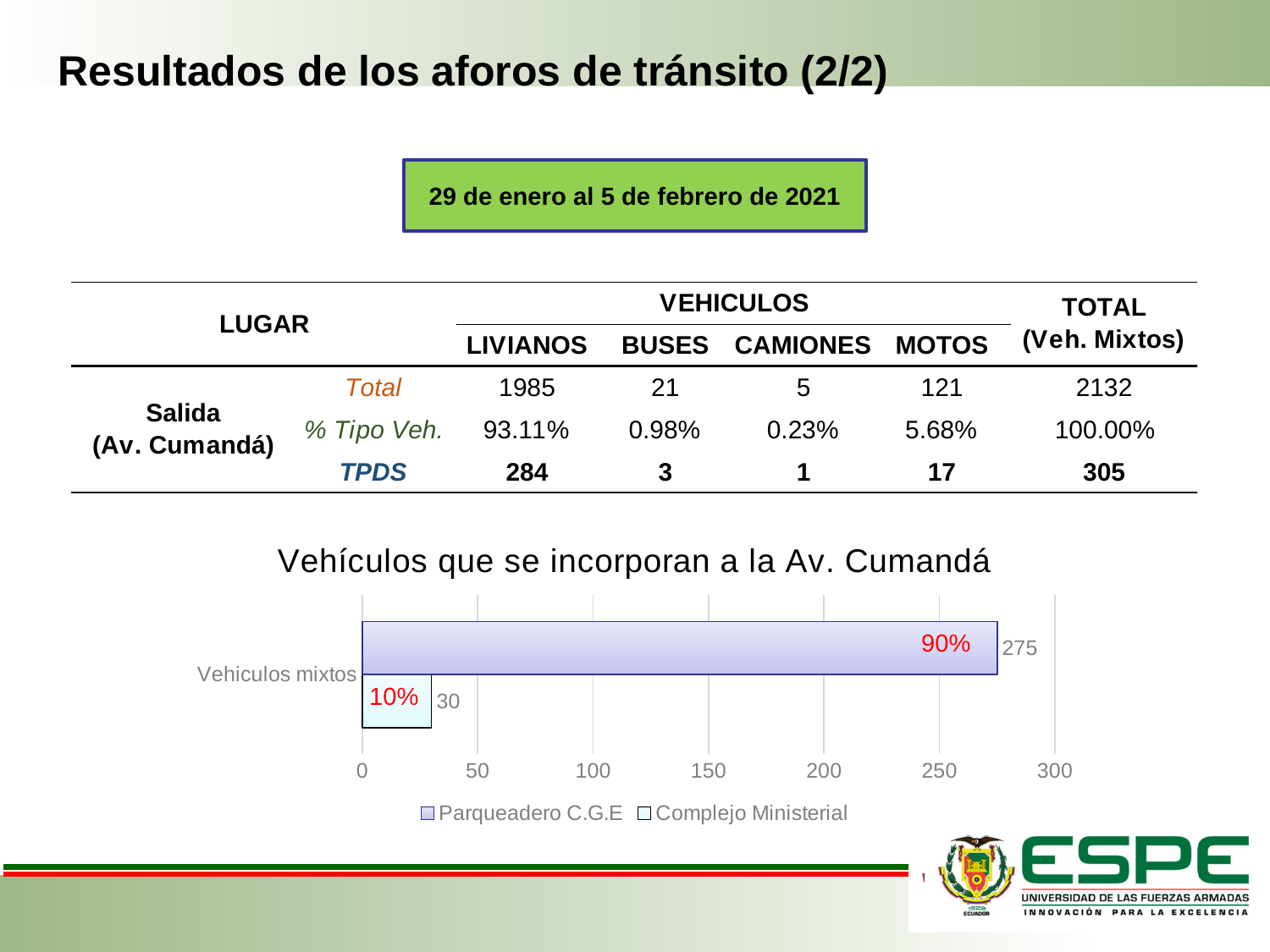
In the chart 'Vehículos que se incorporan a la Av. Cumandá', what is the value for Complejo Ministerial? 30 In the chart 'Vehículos que se incorporan a la Av. Cumandá', what percentage label is shown on the Complejo Ministerial bar? 10% In the chart 'Vehículos que se incorporan a la Av. Cumandá', what is the value for Parqueadero C.G.E? 275 In the chart 'Vehículos que se incorporan a la Av. Cumandá', what is the difference between the Parqueadero C.G.E value and the Complejo Ministerial value? 245 In the chart 'Vehículos que se incorporan a la Av. Cumandá', what percentage label is shown on the Parqueadero C.G.E bar? 90% In the chart 'Vehículos que se incorporan a la Av. Cumandá', which series has the lower value? Complejo Ministerial What is the category label on the vertical axis of the chart 'Vehículos que se incorporan a la Av. Cumandá'? Vehiculos mixtos In the chart 'Vehículos que se incorporan a la Av. Cumandá', which series has the higher value? Parqueadero C.G.E What type of chart is shown under the title 'Vehículos que se incorporan a la Av. Cumandá'? Bar chart In the chart 'Vehículos que se incorporan a la Av. Cumandá', is the value for Parqueadero C.G.E greater or less than 250? greater How many categories are shown on the vertical axis of the chart 'Vehículos que se incorporan a la Av. Cumandá'? 1 How many series does the legend of the chart 'Vehículos que se incorporan a la Av. Cumandá' list? 2